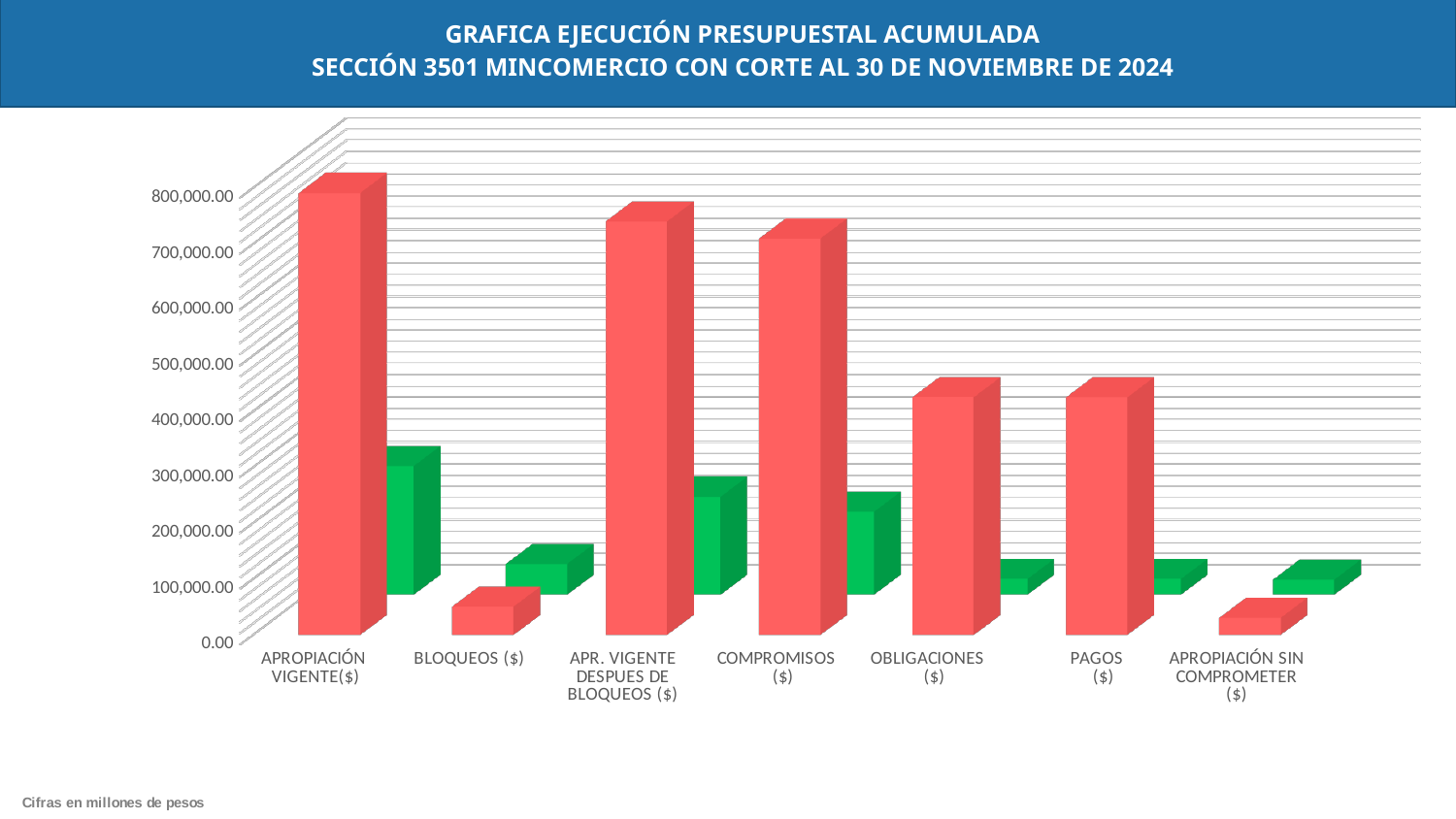
How many categories are shown on the x axis of the chart? 7 According to the note at the bottom of the slide, in what units are the figures expressed? millones de pesos Is the red bar for COMPROMISOS ($) greater or less than 600,000.00? greater Which category has the shortest red bar? APROPIACIÓN SIN COMPROMETER ($) Which has the larger red bar, APROPIACIÓN VIGENTE($) or COMPROMISOS ($)? APROPIACIÓN VIGENTE($) Which has the larger red bar, COMPROMISOS ($) or OBLIGACIONES ($)? COMPROMISOS ($) Which category has the tallest red bar? APROPIACIÓN VIGENTE($) Is the red bar for OBLIGACIONES ($) greater or less than 500,000.00? less What kind of chart is shown on the slide? bar chart Is the red bar for BLOQUEOS ($) greater or less than 100,000.00? less What is the title of the chart on the slide? GRAFICA EJECUCIÓN PRESUPUESTAL ACUMULADA SECCIÓN 3501 MINCOMERCIO CON CORTE AL 30 DE NOVIEMBRE DE 2024